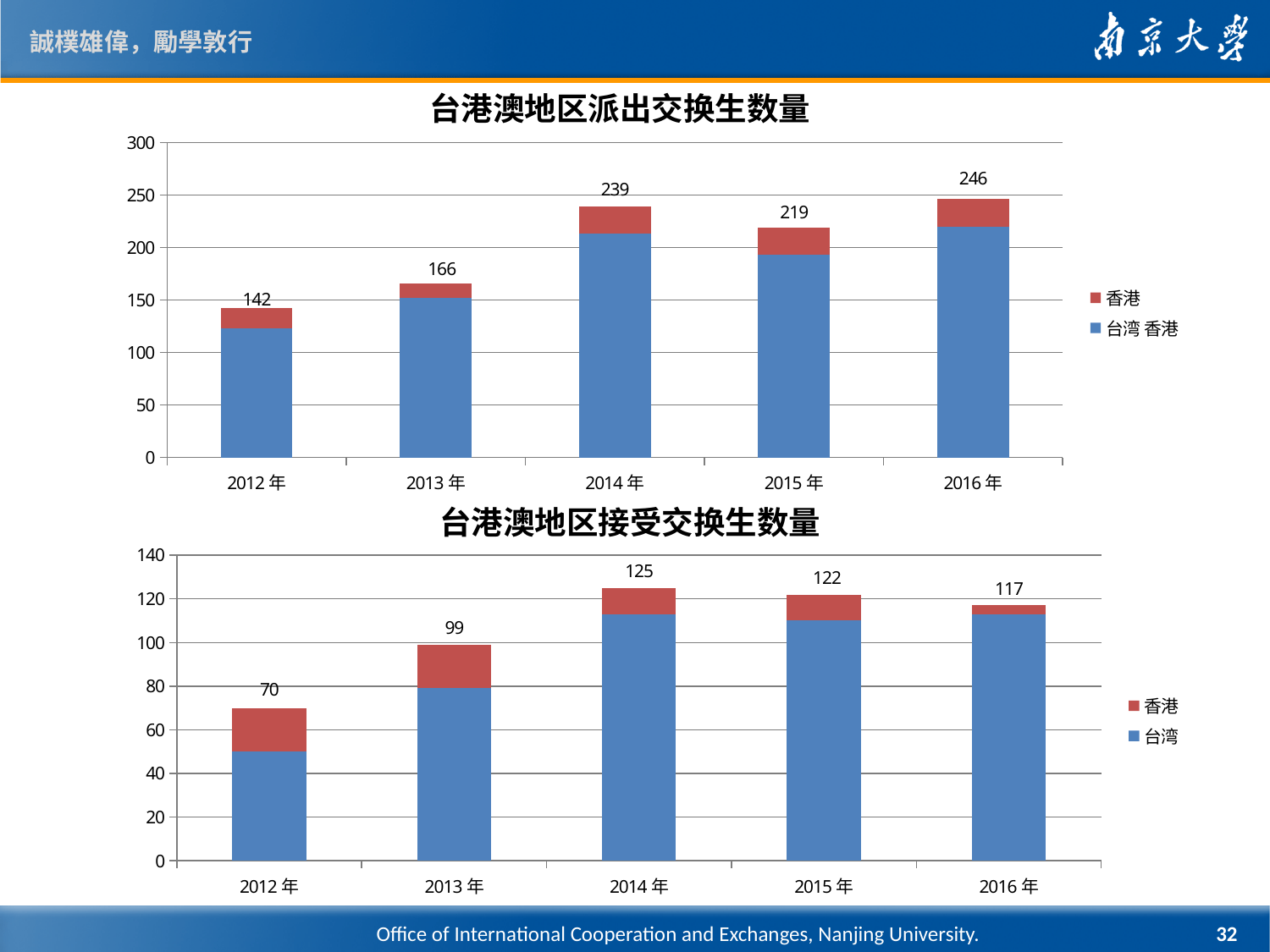
In the top chart (台港澳地区派出交换生数量), which year has the highest total? 2016 年 What kind of chart is the bottom chart (台港澳地区接受交换生数量)? Stacked bar chart In the bottom chart (台港澳地区接受交换生数量), which year has the highest total? 2014 年 In the top chart (台港澳地区派出交换生数量), how many series does the legend list? 2 In the bottom chart (台港澳地区接受交换生数量), what is the difference between the totals for 2014 年 and 2012 年? 55 In the bottom chart (台港澳地区接受交换生数量), how many years are shown on the x axis? 5 In the bottom chart (台港澳地区接受交换生数量), which total is larger, 2015 年 or 2016 年? 2015 年 In the top chart (台港澳地区派出交换生数量), is the 台湾 香港 segment for 2015 年 greater or less than 150? greater In the top chart (台港澳地区派出交换生数量), what is the difference between the totals for 2016 年 and 2012 年? 104 In the bottom chart (台港澳地区接受交换生数量), what is the total for 2013 年? 99 In the top chart (台港澳地区派出交换生数量), what is the total number of exchange students sent in 2014 年? 239 In the top chart (台港澳地区派出交换生数量), which year has the lowest total? 2012 年